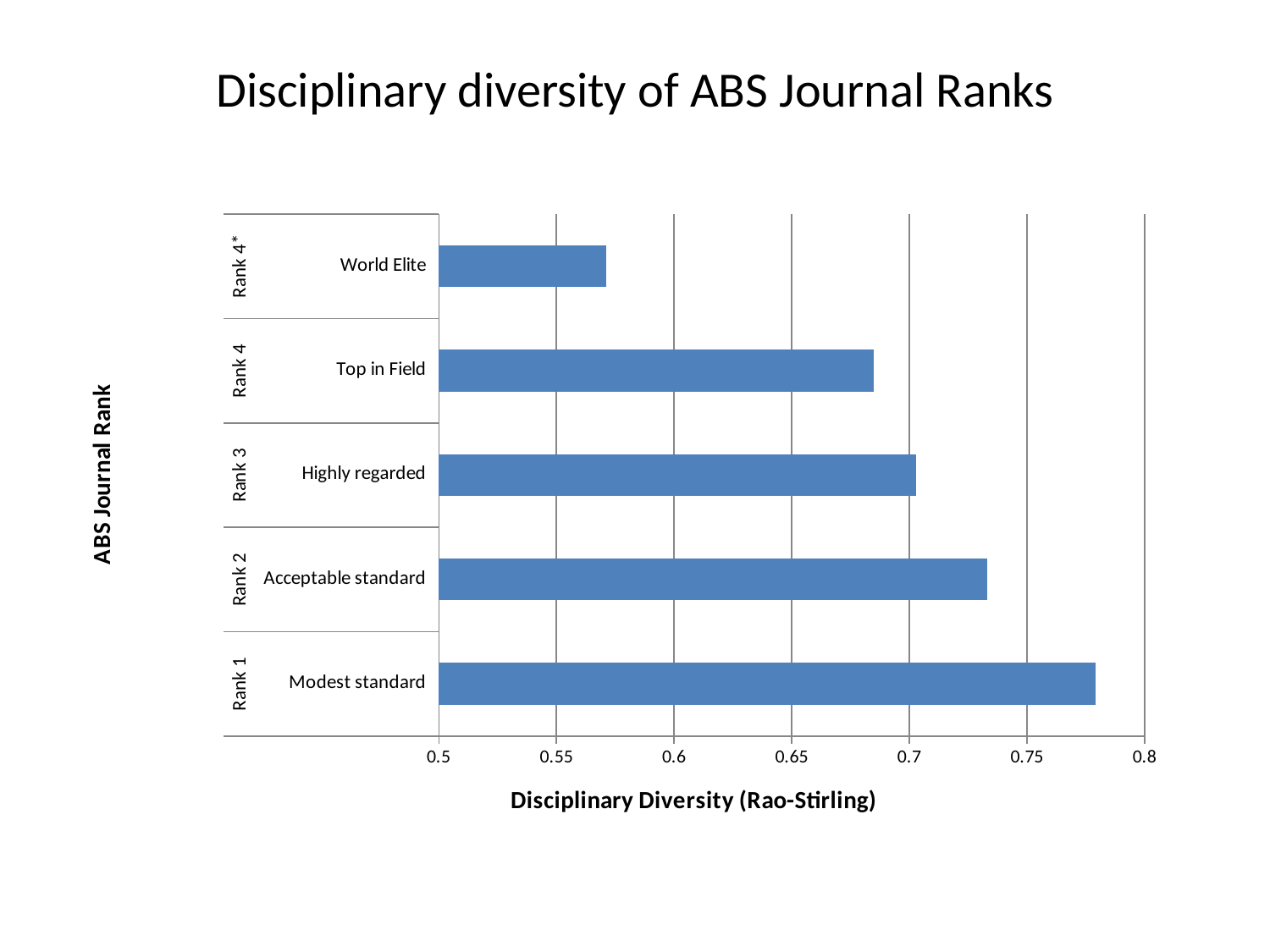
Is the disciplinary diversity for Acceptable standard (Rank 2) greater or less than 0.7? greater How many ABS journal rank categories are plotted in the chart? 5 Which category has the highest disciplinary diversity? Modest standard (Rank 1) Is the disciplinary diversity for Modest standard (Rank 1) greater or less than 0.75? greater Which category has the lowest disciplinary diversity? World Elite (Rank 4*) Is the disciplinary diversity for Top in Field (Rank 4) greater or less than 0.7? less What is the label of the horizontal axis? Disciplinary Diversity (Rao-Stirling) What kind of chart is shown on the slide? bar chart Which has a higher disciplinary diversity, Acceptable standard (Rank 2) or Top in Field (Rank 4)? Acceptable standard (Rank 2) What is the title of the chart? Disciplinary diversity of ABS Journal Ranks Does disciplinary diversity rise or fall as the ABS journal rank goes from Rank 4* down to Rank 1? rise